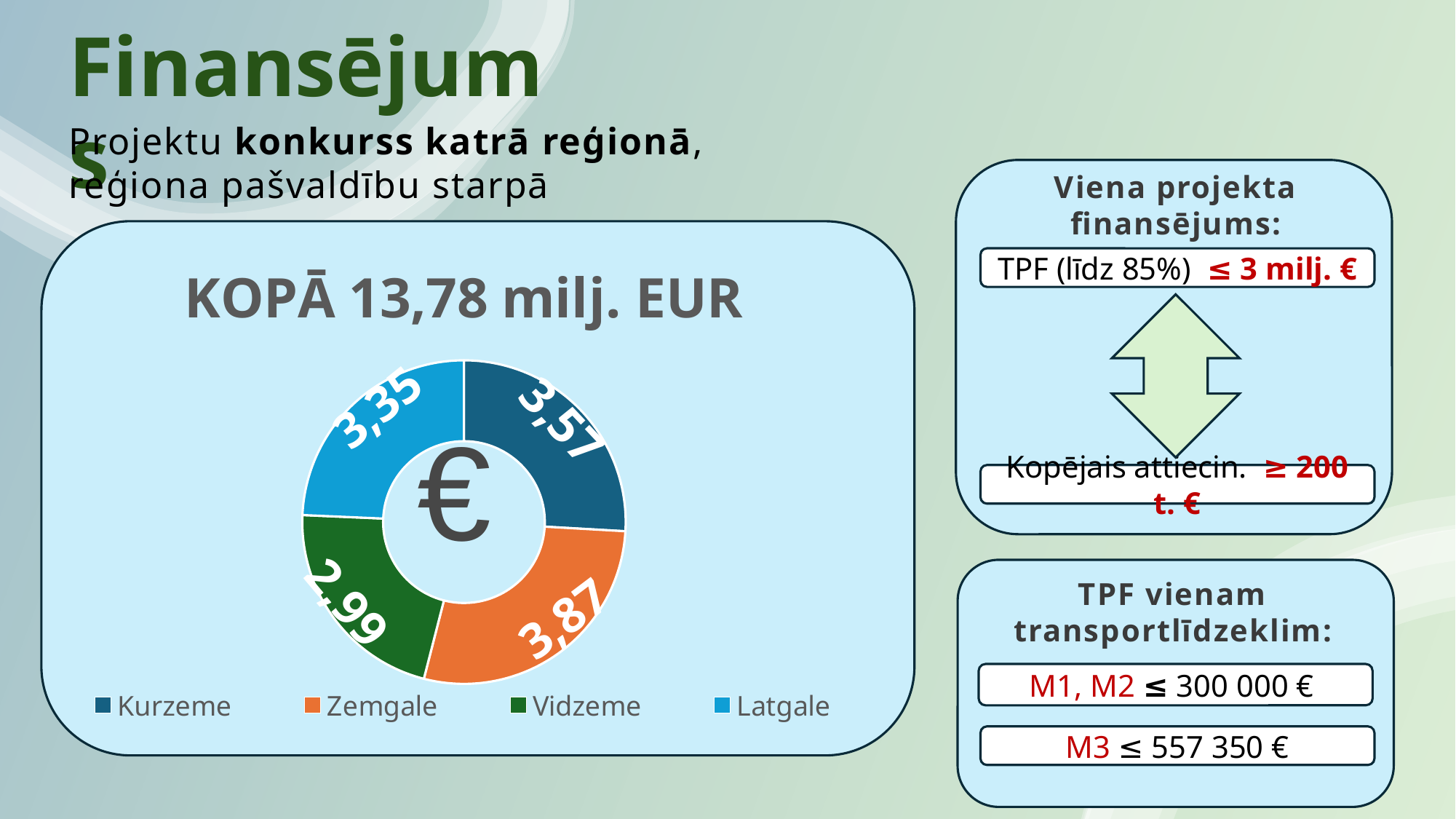
Which is larger, the value for Kurzeme or the value for Latgale? Kurzeme What is the difference between the values for Kurzeme and Latgale? 0,22 How many regions are shown in the doughnut chart? 4 What value is shown for Zemgale in the doughnut chart? 3,87 What total amount is stated above the doughnut chart? 13,78 milj. EUR What value is shown for Kurzeme in the doughnut chart? 3,57 What type of chart is used to show the regional funding? doughnut chart What is the difference between the values for Zemgale and Vidzeme? 0,88 What value is shown for Latgale in the doughnut chart? 3,35 Which region has the smallest value in the doughnut chart? Vidzeme Which region has the largest value in the doughnut chart? Zemgale What value is shown for Vidzeme in the doughnut chart? 2,99